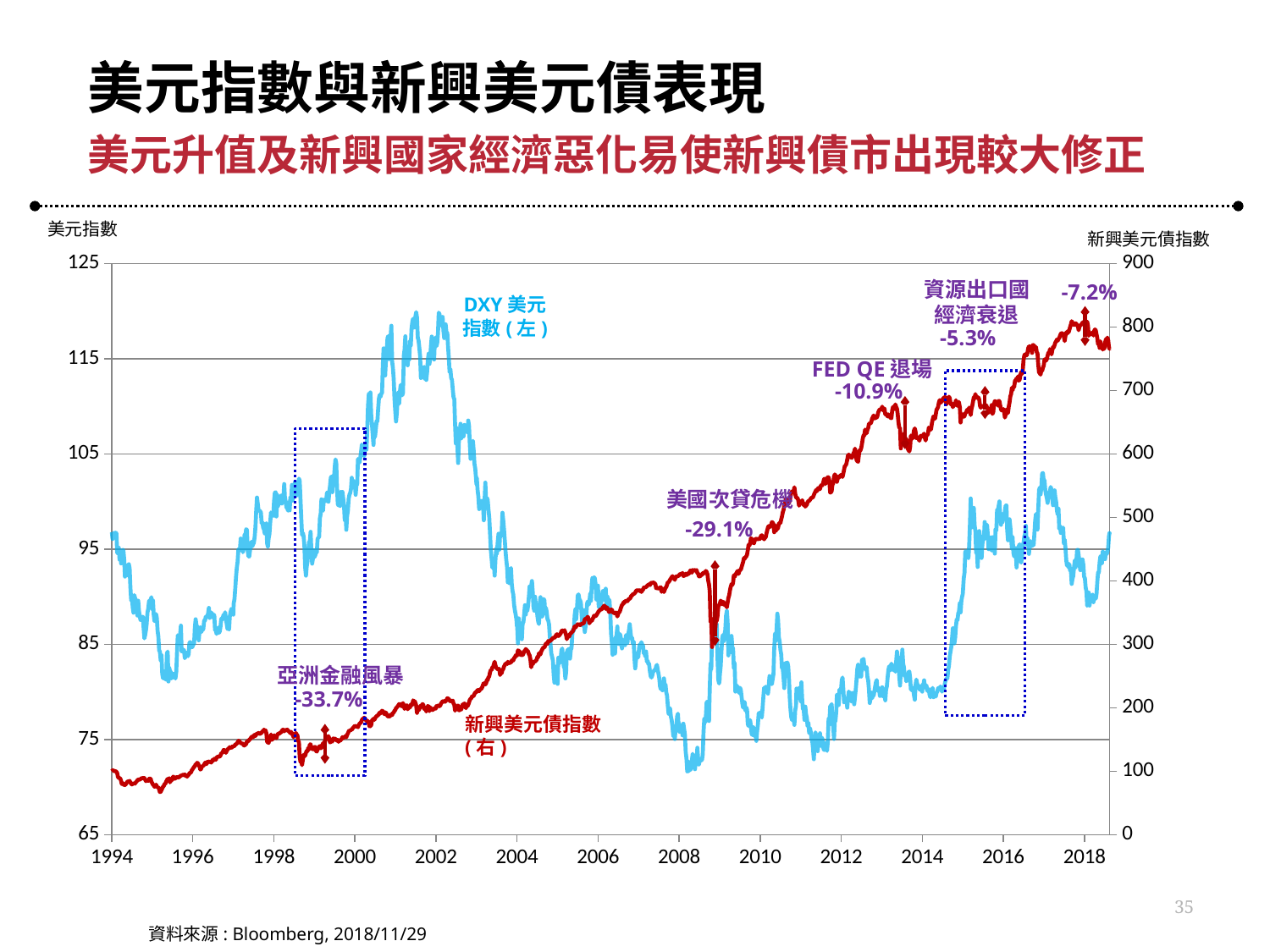
What percentage decline is annotated for 美國次貸危機 (US subprime crisis)? -29.1% What is the percentage annotated near the 2018 end of the red line? -7.2% What kind of chart is shown on the slide? line chart How many data series are plotted on the chart? 2 Which annotated event shows the largest percentage decline? 亞洲金融風暴 (-33.7%) What percentage decline is annotated for 亞洲金融風暴 (Asian financial crisis)? -33.7% Which annotated event shows the smallest percentage decline? 資源出口國經濟衰退 (-5.3%) Is the DXY 美元指數 value around 2001 greater or less than 115? greater What percentage decline is annotated for 資源出口國經濟衰退? -5.3% What percentage decline is annotated for FED QE 退場? -10.9% Does the 新興美元債指數 (red line) generally rise or fall from 1994 to 2018? rise Which axis does the DXY 美元指數 series use, left or right? left